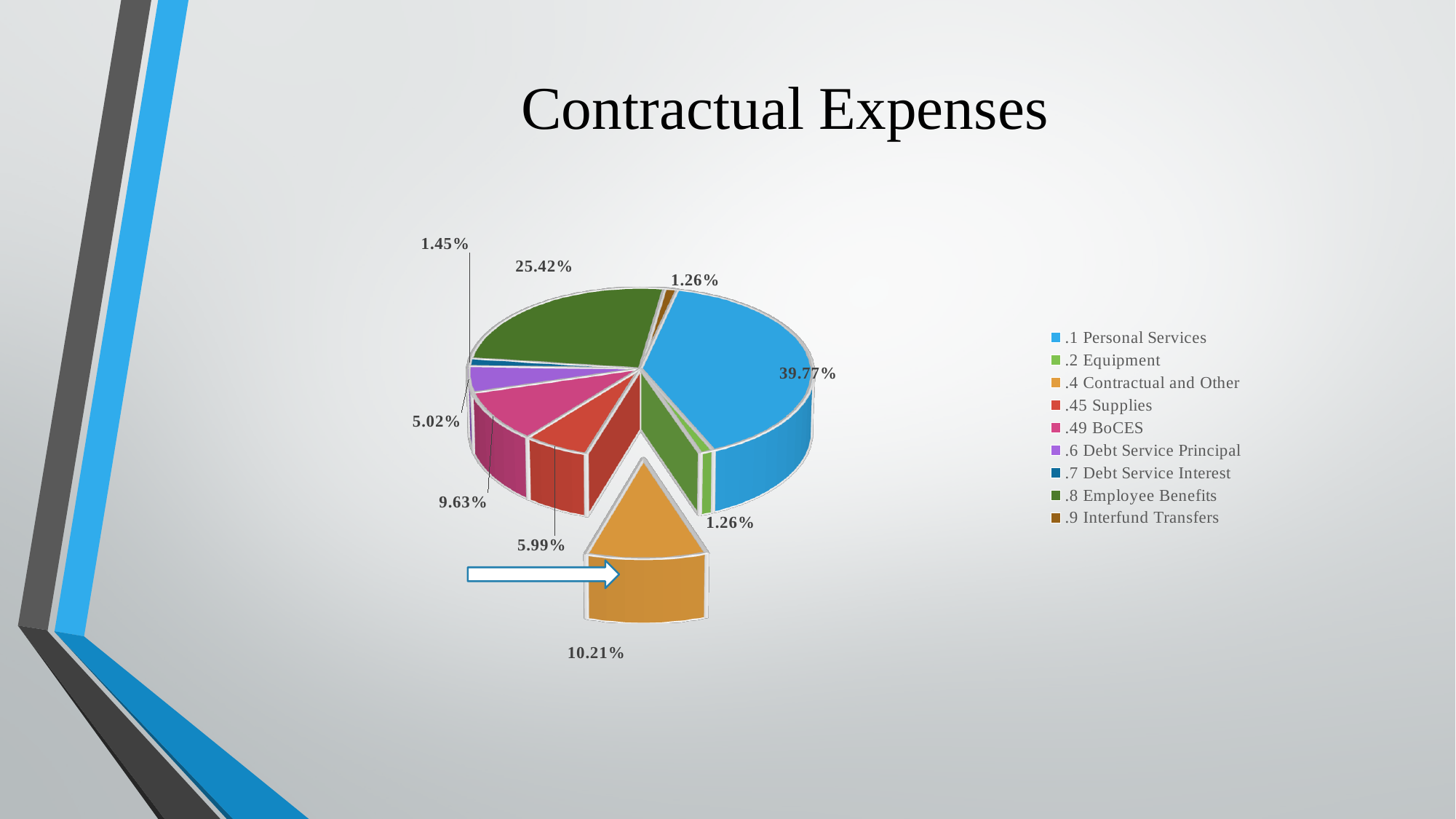
What type of chart is shown on the slide? pie chart How many categories does the legend list? 9 What is the difference between the .1 Personal Services share and the .8 Employee Benefits share? 14.35% What percentage does the .45 Supplies slice represent? 5.99% What percentage does the .1 Personal Services slice represent? 39.77% What percentage does the .4 Contractual and Other slice represent? 10.21% What percentage does the .6 Debt Service Principal slice represent? 5.02% What percentage does the .49 BoCES slice represent? 9.63% Which is larger, the .49 BoCES share or the .45 Supplies share? .49 BoCES Which category has the largest share of the pie? .1 Personal Services What is the title of the chart? Contractual Expenses What percentage does the .8 Employee Benefits slice represent? 25.42%